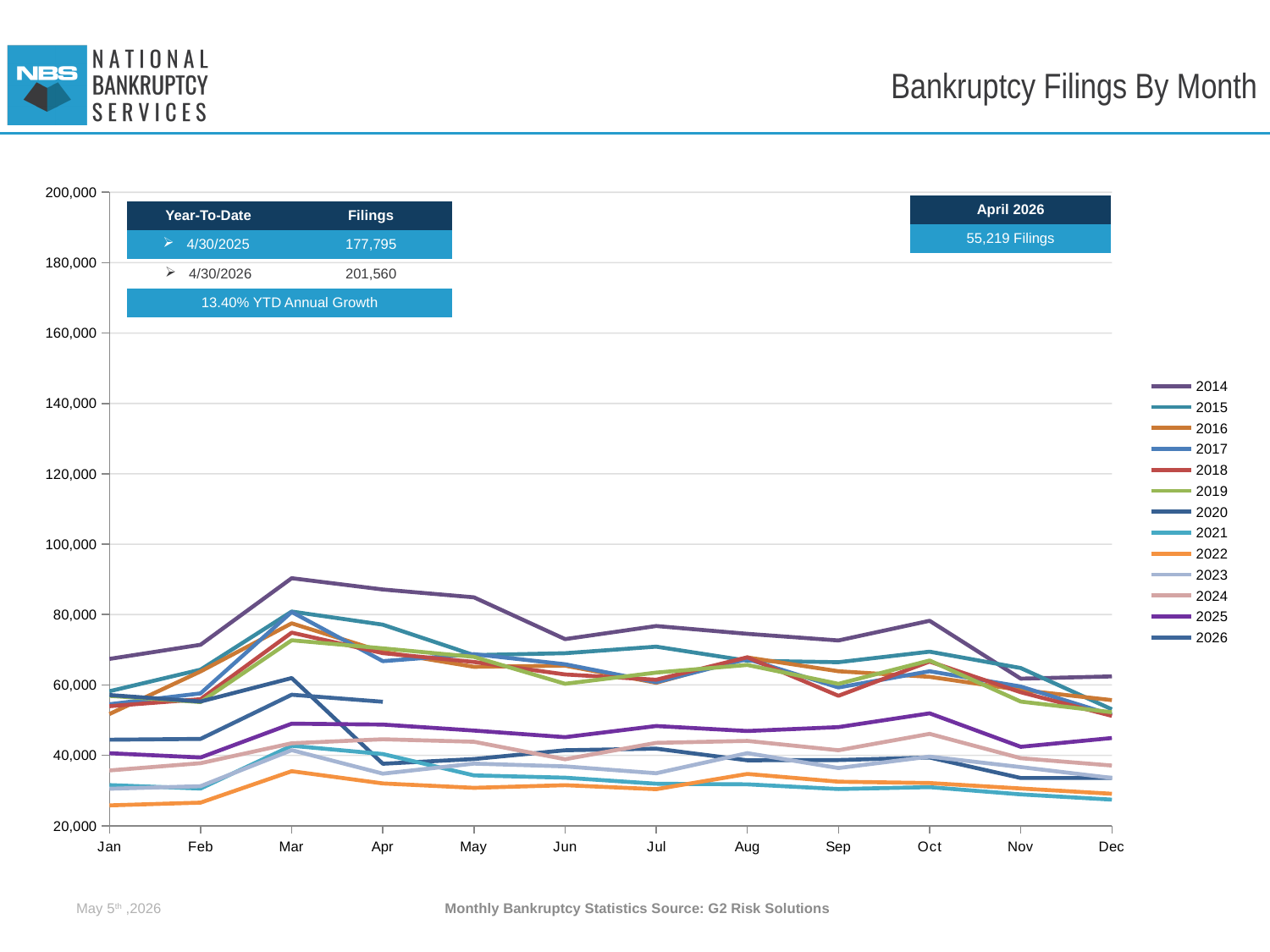
Which year has the highest filings in Mar? 2014 What YTD annual growth percentage is shown on the slide? 13.40% YTD Annual Growth Which year has the lowest filings in Jan? 2022 How many filings are reported for April 2026? 55,219 Filings How many series does the legend list? 13 Is the value for 2014 in Mar greater or less than 80,000? greater How many months are shown along the x axis? 12 What kind of chart is shown on the slide? line chart What is the year-to-date filings figure as of 4/30/2025? 177,795 What is the year-to-date filings figure as of 4/30/2026? 201,560 By how much do year-to-date filings as of 4/30/2026 exceed those as of 4/30/2025? 23,765 Is the value for 2022 in Jan greater or less than 40,000? less